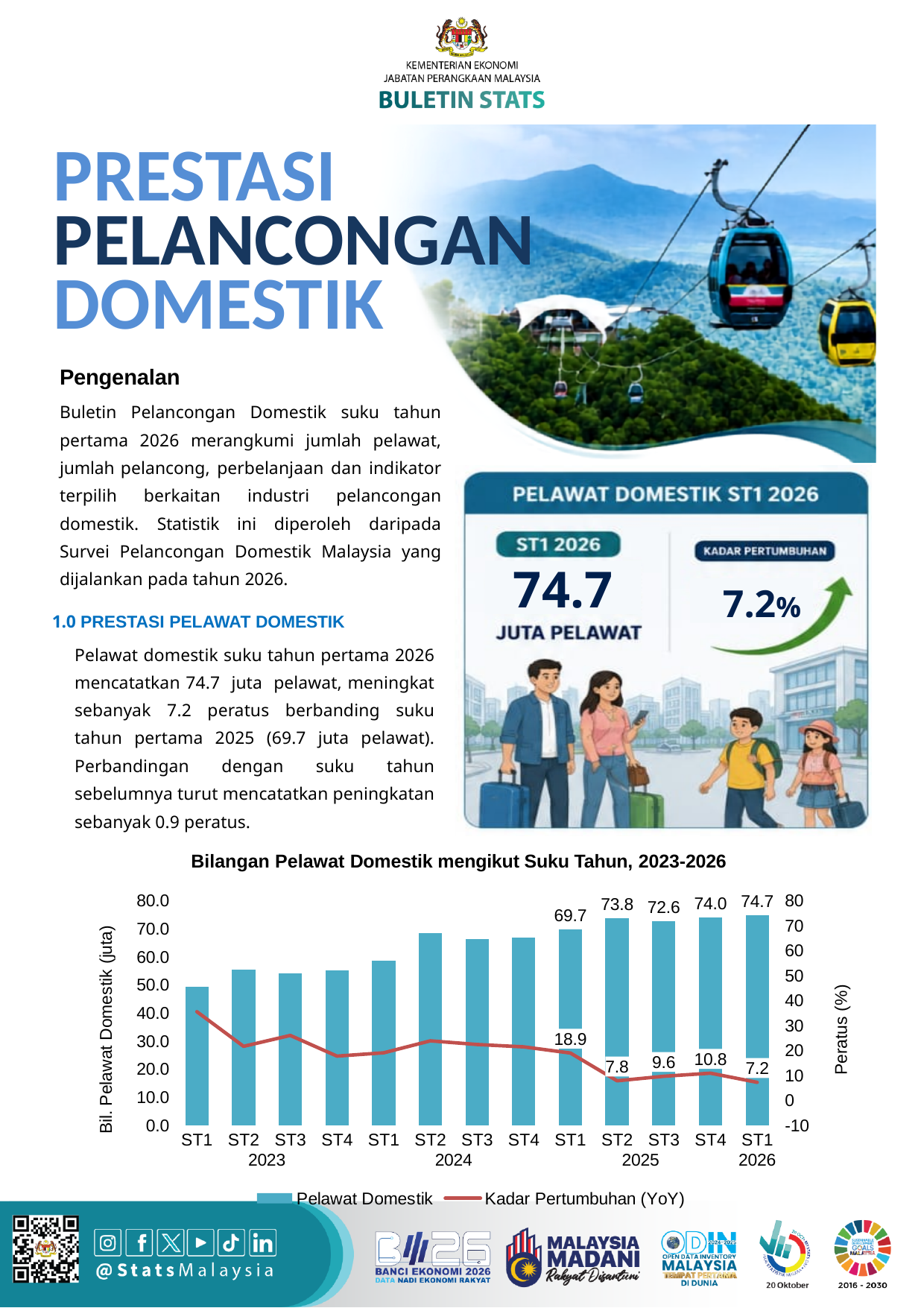
What is the value of Pelawat Domestik for ST2 2025? 73.8 Among the labelled Kadar Pertumbuhan (YoY) values, which quarter has the lowest? ST1 2026 What is the Kadar Pertumbuhan (YoY) value for ST1 2026? 7.2 Is the Pelawat Domestik value for ST1 2023 greater or less than 60.0? less Which is larger, Pelawat Domestik for ST2 2025 or ST3 2025? ST2 2025 What is the value of Pelawat Domestik for ST1 2026? 74.7 How many series does the legend list? 2 What is the difference in Pelawat Domestik between ST1 2026 and ST1 2025? 5.0 Which quarter has the highest number of Pelawat Domestik? ST1 2026 What is the label of the right-hand vertical axis? Peratus (%) What is the Kadar Pertumbuhan (YoY) value for ST1 2025? 18.9 How many quarters (bars) are shown in the chart? 13